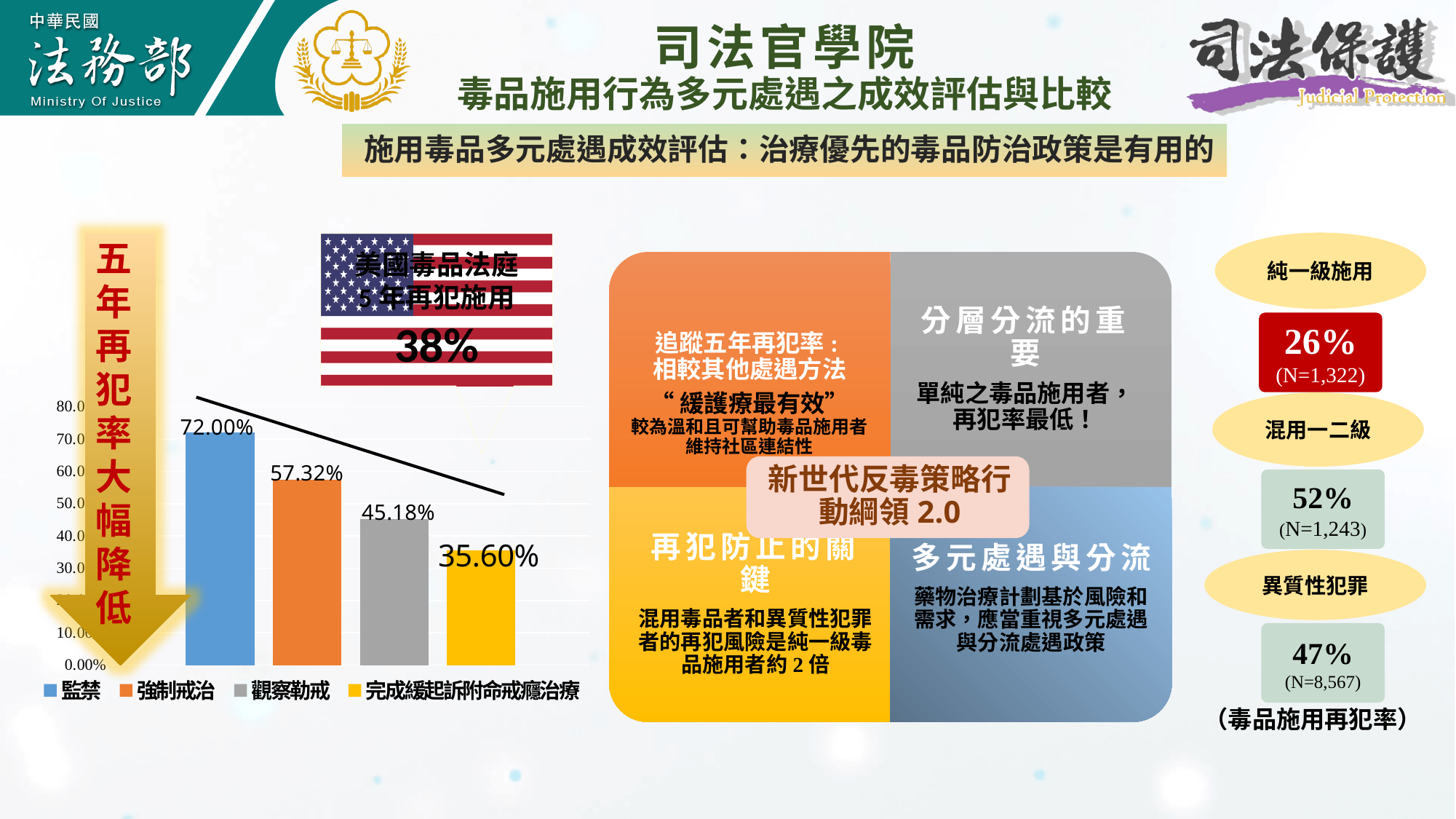
What is the value for 強制戒治 in the bar chart? 57.32% Which is larger in the bar chart, the value for 強制戒治 or the value for 觀察勒戒? 強制戒治 What is the value for 監禁 in the bar chart? 72.00% What is the difference between the values for 監禁 and 完成緩起訴附命戒癮治療 in the bar chart? 36.40% What is the value for 完成緩起訴附命戒癮治療 in the bar chart? 35.60% Is the value for 觀察勒戒 in the bar chart greater or less than 50.00%? less Do the values in the bar chart rise or fall from left to right? fall How many bars are plotted in the bar chart? 4 Which category has the lowest value in the bar chart? 完成緩起訴附命戒癮治療 What is the value for 觀察勒戒 in the bar chart? 45.18% Which category has the highest value in the bar chart? 監禁 How many entries does the legend of the bar chart list? 4